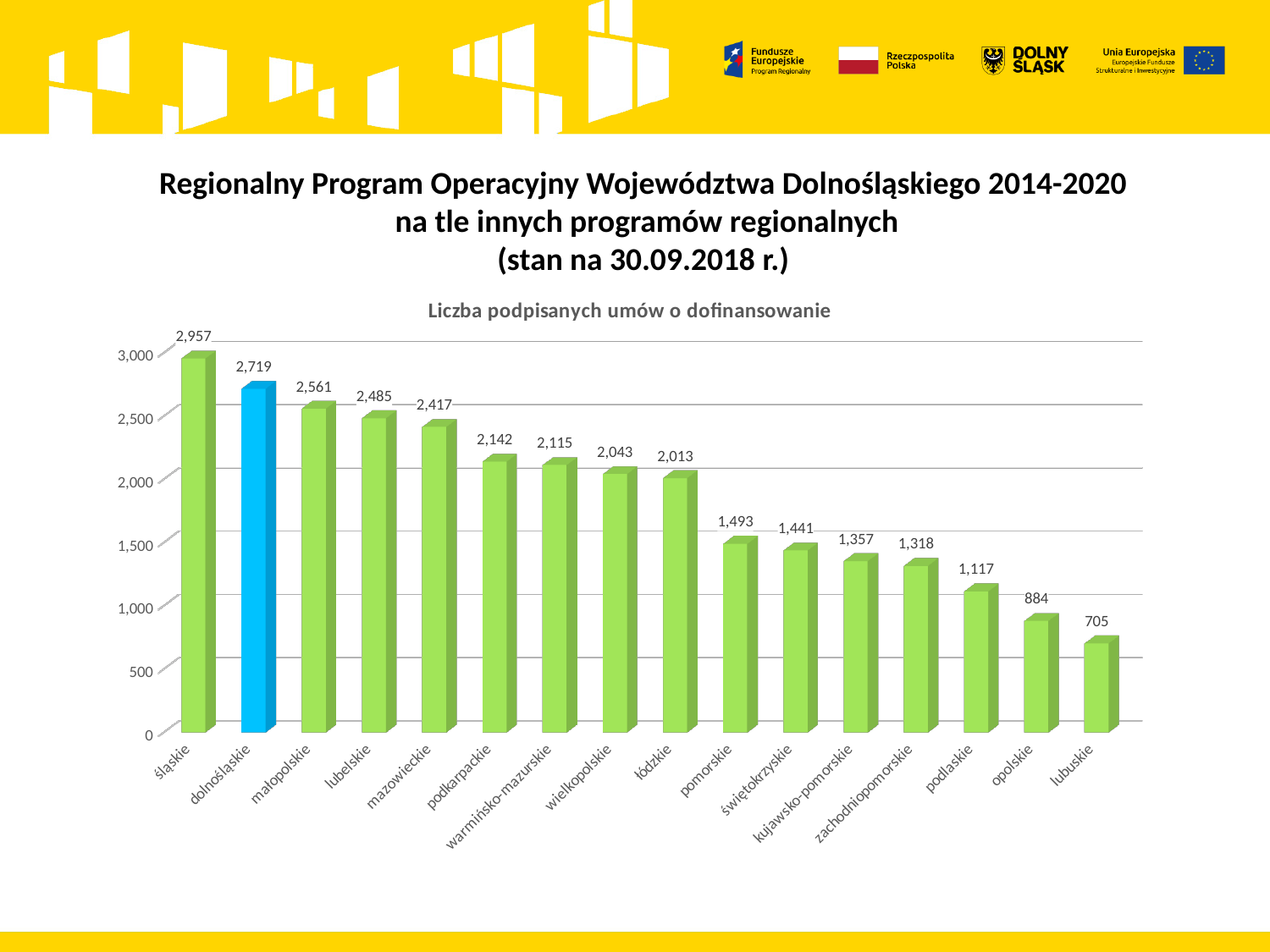
Which region has the highest number of signed agreements? śląskie How many regions are shown in the chart? 16 Which region has the lowest number of signed agreements? lubuskie Which is larger, the value for pomorskie or the value for świętokrzyskie? pomorskie What is the value for lubelskie? 2,485 Which bar is highlighted in a different colour (blue) from the others? dolnośląskie What is the value for dolnośląskie in the chart 'Liczba podpisanych umów o dofinansowanie'? 2,719 What kind of chart is shown on the slide? bar chart What is the difference between the values for śląskie and dolnośląskie? 238 What is the difference between the values for opolskie and lubuskie? 179 Is the value for mazowieckie greater or less than 2,500? less What is the value for podlaskie? 1,117